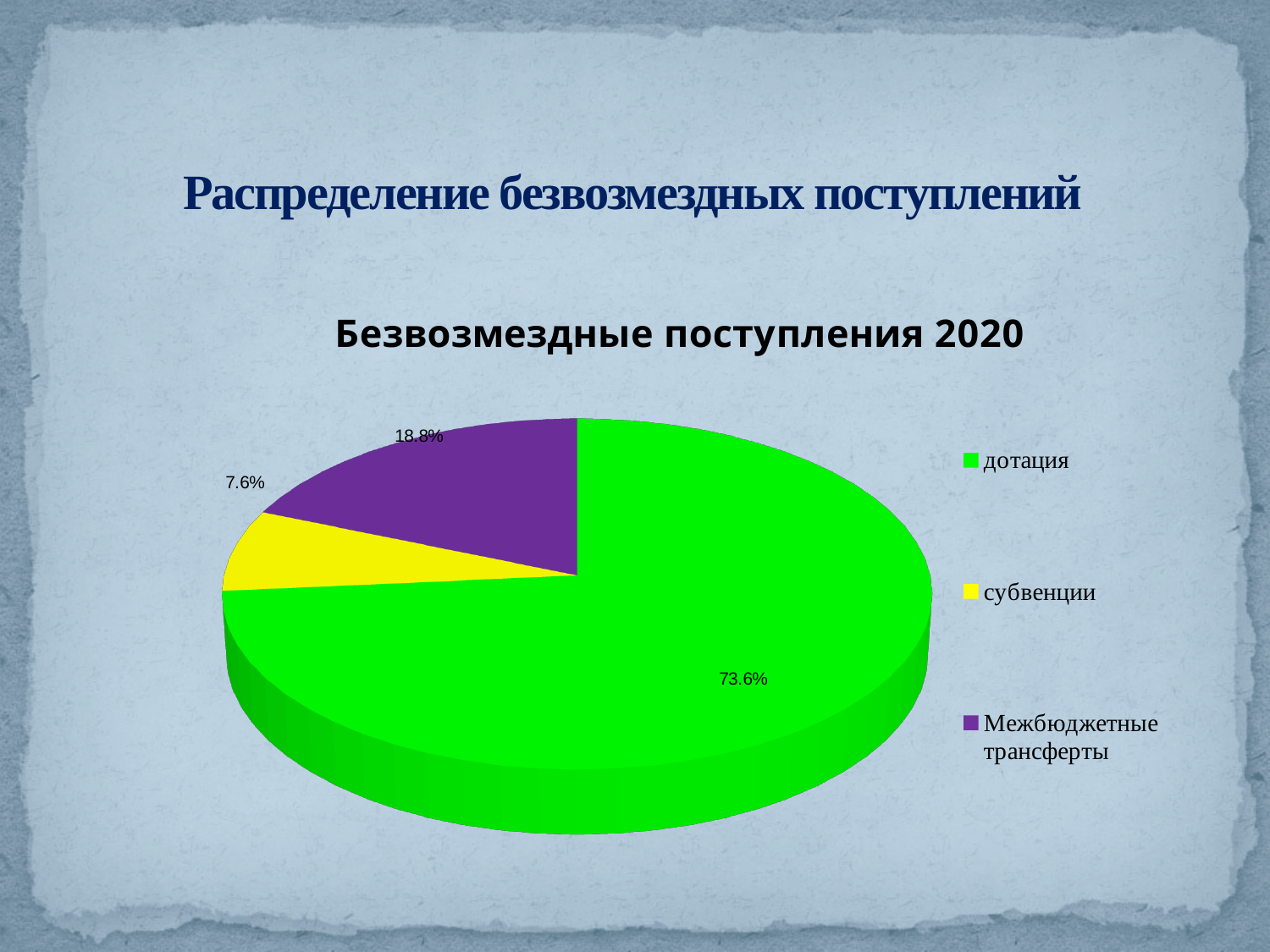
What is the value shown for субвенции? 7.6% What share of the pie does дотация have? 73.6% What is the difference between the shares of Межбюджетные трансферты and субвенции? 11.2% What is the value shown for Межбюджетные трансферты? 18.8% Which is larger, the share of субвенции or the share of Межбюджетные трансферты? Межбюджетные трансферты What kind of chart is shown on the slide? Pie chart Which category has the smallest slice of the pie? субвенции What is the title of the chart? Безвозмездные поступления 2020 Which colour represents субвенции in the legend? Yellow How many categories are shown in the pie chart? 3 What is the difference between the shares of дотация and Межбюджетные трансферты? 54.8% Which category has the largest slice of the pie? дотация